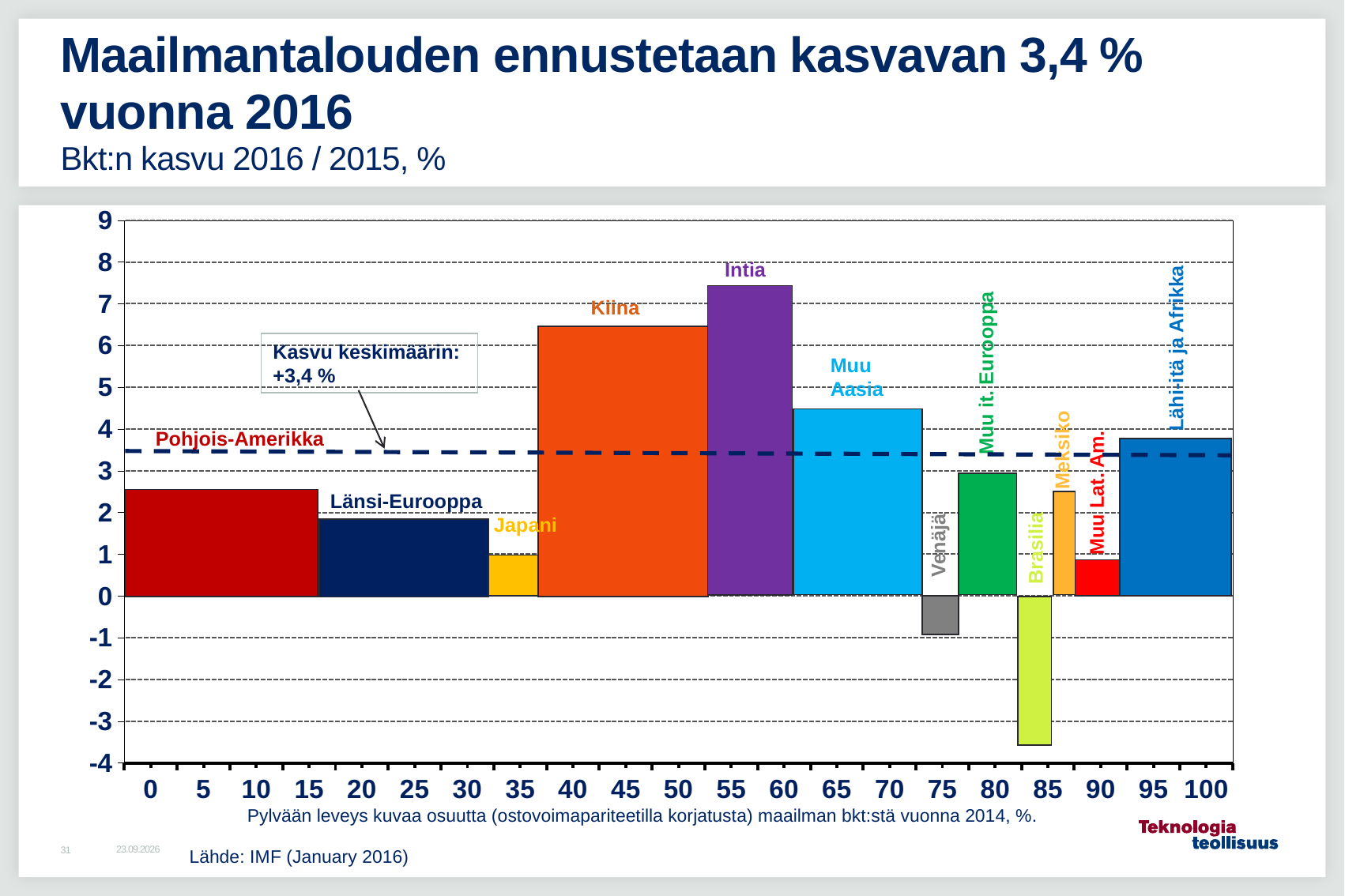
What average growth value is given for the dashed line in the chart? +3,4 % What kind of chart is shown on the slide? bar chart Is the value for Pohjois-Amerikka greater or less than 3? less How many regions (bars) are shown in the chart? 12 Is the value for Muu Aasia greater or less than 4? greater Is the value for Kiina greater or less than 6? greater Which region has the lowest GDP growth forecast in the chart? Brasilia Which has the larger value, Kiina or Muu Aasia? Kiina Which region has the highest GDP growth forecast in the chart? Intia According to the note below the chart, what does the width of each bar represent? Share of world GDP in 2014 (PPP-adjusted), %